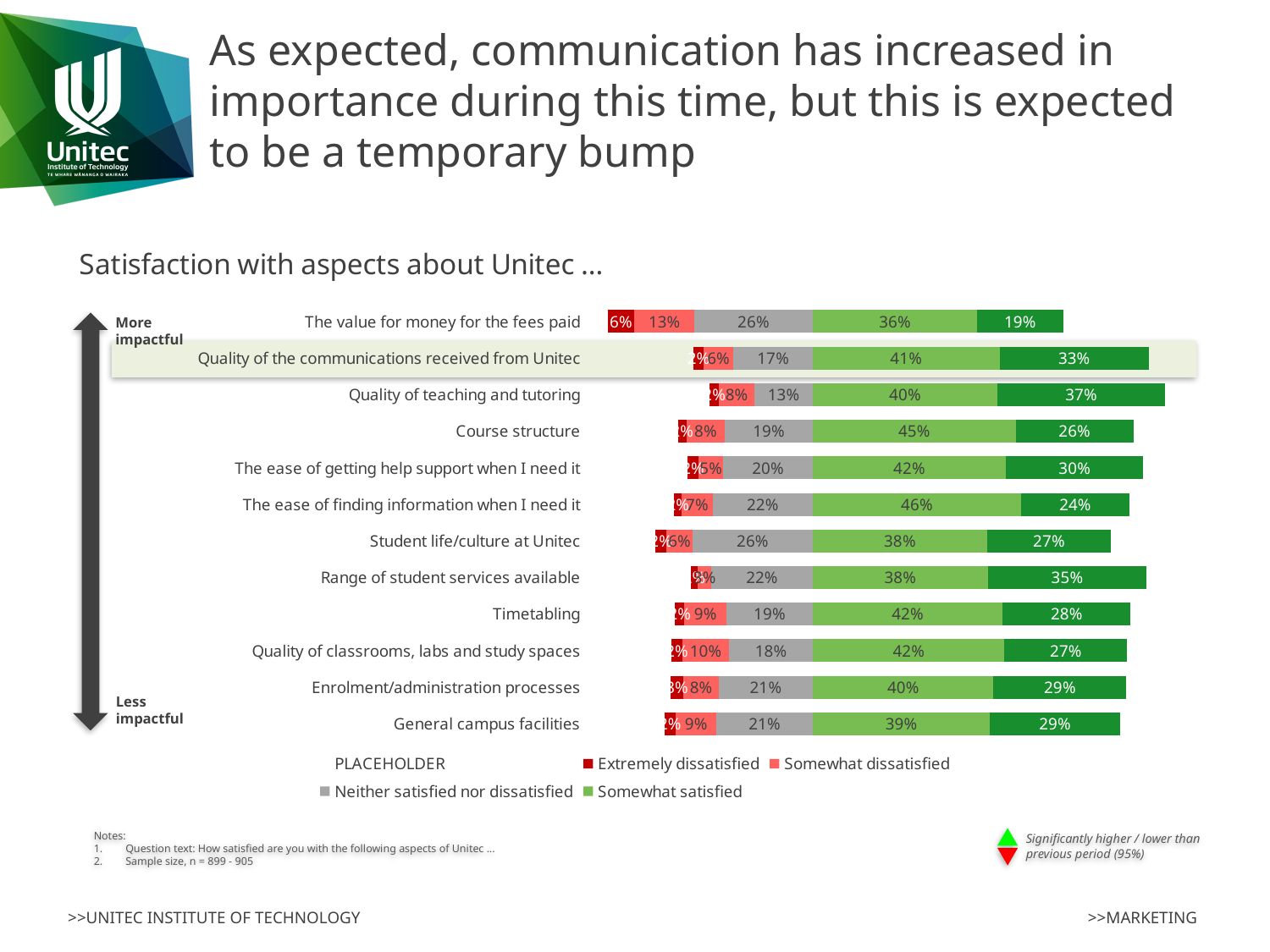
What is the difference in 'Somewhat satisfied' values between Course structure and Quality of teaching and tutoring? 5 percentage points What is the 'Somewhat dissatisfied' value for Quality of classrooms, labs and study spaces? 10% What is the 'Extremely dissatisfied' value for The value for money for the fees paid? 6% How many aspects of Unitec are listed as categories in the chart? 12 What kind of chart is shown on the slide? Stacked bar chart What is the 'Somewhat satisfied' value for Course structure? 45% Which aspect has the highest 'Somewhat satisfied' value? The ease of finding information when I need it What is the 'Neither satisfied nor dissatisfied' value for The value for money for the fees paid? 26% Which aspect is highlighted with a shaded band in the chart? Quality of the communications received from Unitec Which has a larger 'Neither satisfied nor dissatisfied' value: Student life/culture at Unitec or Timetabling? Student life/culture at Unitec Which aspect has the lowest 'Somewhat satisfied' value? The value for money for the fees paid Which aspect has the highest 'Somewhat dissatisfied' value? The value for money for the fees paid